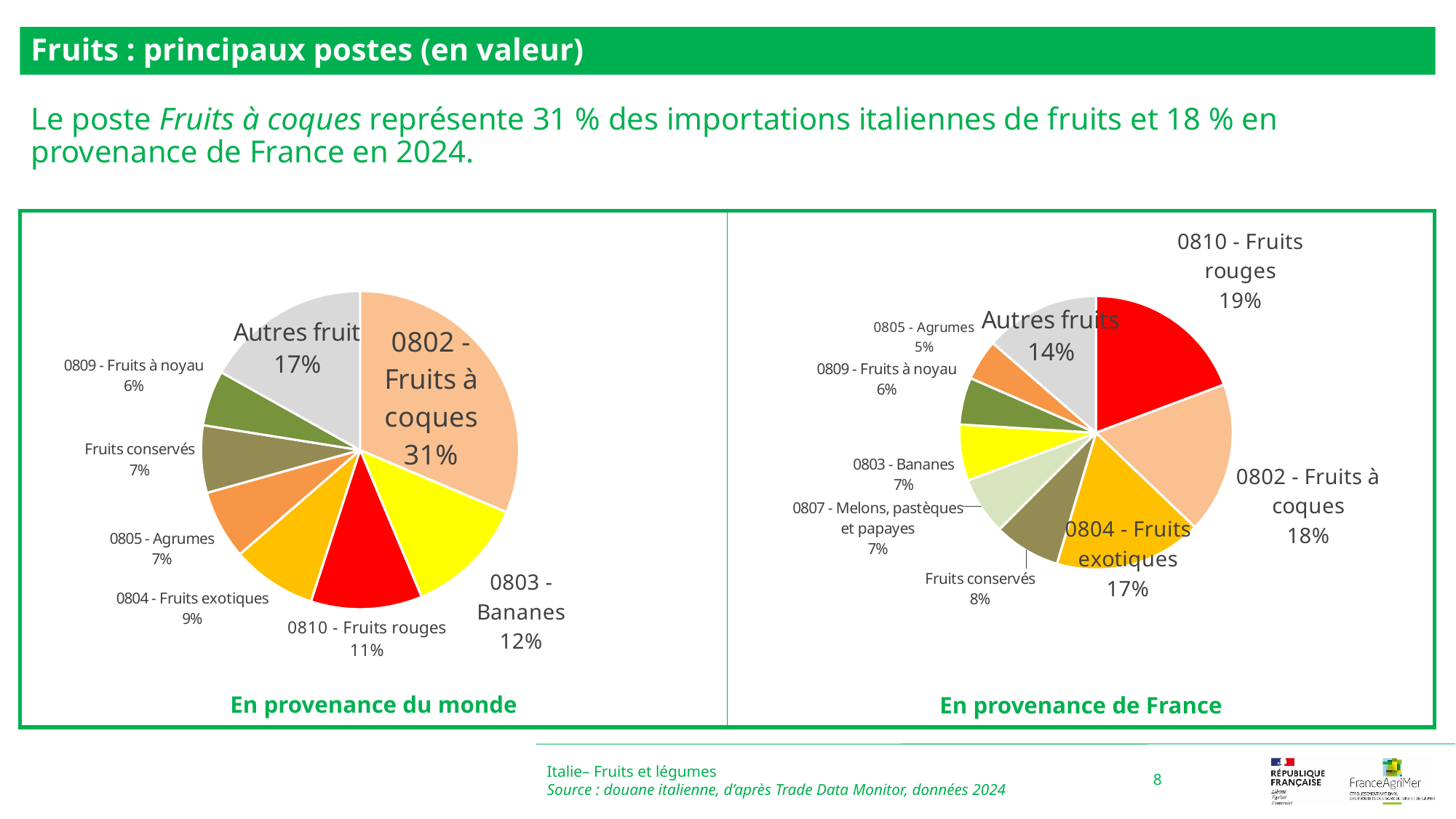
In the 'En provenance du monde' chart, which is larger: '0804 - Fruits exotiques' or '0809 - Fruits à noyau'? 0804 - Fruits exotiques In the 'En provenance du monde' chart, which category has the largest slice? 0802 - Fruits à coques How many slices does the 'En provenance du monde' pie chart have? 8 In the 'En provenance de France' chart, what is the difference in percentage points between '0802 - Fruits à coques' and '0804 - Fruits exotiques'? 1 percentage point What type of chart is used for 'En provenance de France'? Pie chart In the 'En provenance du monde' chart, what share does '0802 - Fruits à coques' represent? 31% In the 'En provenance de France' chart, which category has the smallest slice? 0805 - Agrumes In the 'En provenance de France' chart, which is larger: 'Fruits conservés' or '0803 - Bananes'? Fruits conservés In the 'En provenance du monde' chart, what is the difference in percentage points between '0803 - Bananes' and '0810 - Fruits rouges'? 1 percentage point In the 'En provenance de France' chart, what share does '0810 - Fruits rouges' represent? 19% How many slices does the 'En provenance de France' pie chart have? 9 In the 'En provenance de France' chart, what share does '0807 - Melons, pastèques et papayes' represent? 7%